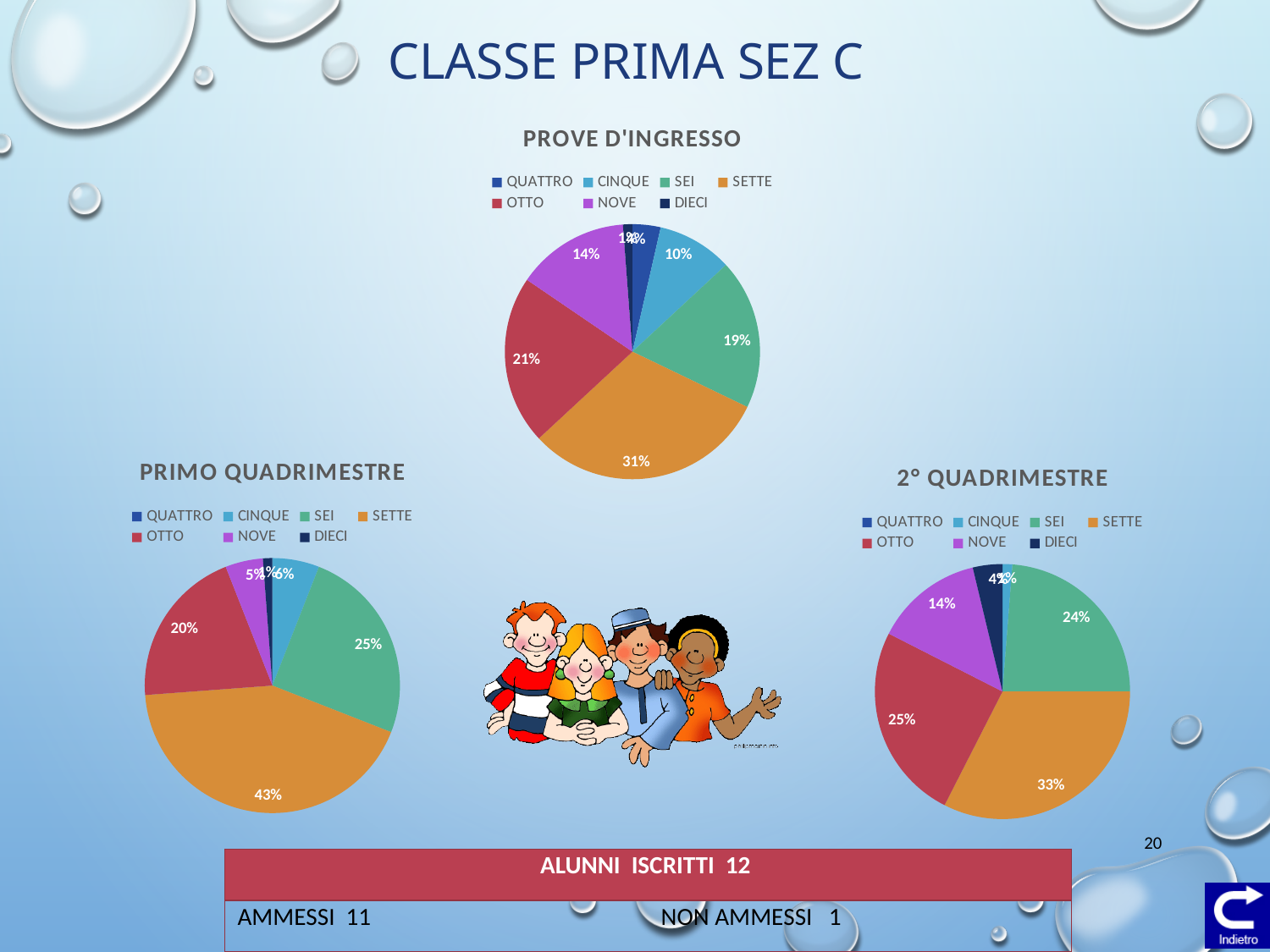
What type of chart is the PRIMO QUADRIMESTRE chart? Pie chart How many entries does the legend of the PROVE D'INGRESSO chart list? 7 In the PROVE D'INGRESSO chart, what share does NOVE have? 14% In the 2° QUADRIMESTRE chart, what share does OTTO have? 25% In the PROVE D'INGRESSO chart, what share does SETTE have? 31% In the PRIMO QUADRIMESTRE chart, what is the difference between the SETTE and SEI shares? 18% In the PROVE D'INGRESSO chart, what is the difference between the OTTO and SEI shares? 2% In the PRIMO QUADRIMESTRE chart, what share does SETTE have? 43% In the 2° QUADRIMESTRE chart, which category has the largest slice? SETTE In the PROVE D'INGRESSO chart, which category has the largest slice? SETTE In the 2° QUADRIMESTRE chart, what is the difference between the SETTE and NOVE shares? 19% In the PRIMO QUADRIMESTRE chart, which is larger, SEI or OTTO? SEI